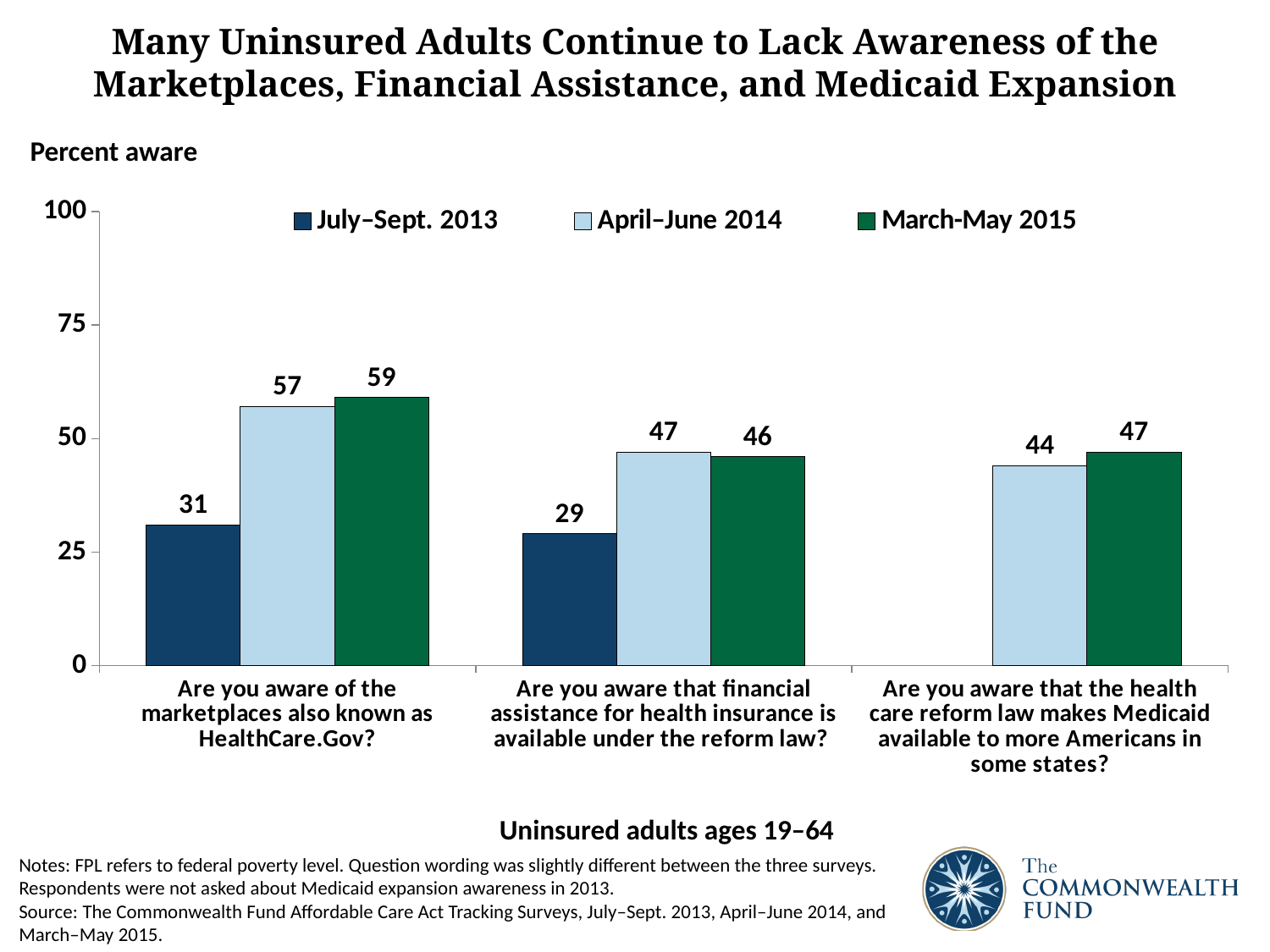
Which survey period has no bar for the Medicaid expansion question? July–Sept. 2013 How many question categories are shown on the x axis? 3 Which survey period has the highest awareness of the marketplaces also known as HealthCare.Gov? March-May 2015 What is the difference between awareness of financial assistance in April–June 2014 and March-May 2015? 1 What percent were aware that the health care reform law makes Medicaid available to more Americans in some states in April–June 2014? 44 Which is larger: awareness of the marketplaces in April–June 2014 or awareness of Medicaid expansion in March-May 2015? Awareness of the marketplaces in April–June 2014 By how many percentage points did awareness of the marketplaces increase from July–Sept. 2013 to March-May 2015? 28 What percent were aware that financial assistance for health insurance is available under the reform law in March-May 2015? 46 Which survey period has the lowest awareness of financial assistance under the reform law? July–Sept. 2013 What percent of uninsured adults were aware of the marketplaces (HealthCare.Gov) in July–Sept. 2013? 31 What kind of chart is shown on the slide? Bar chart How many series does the legend list? 3